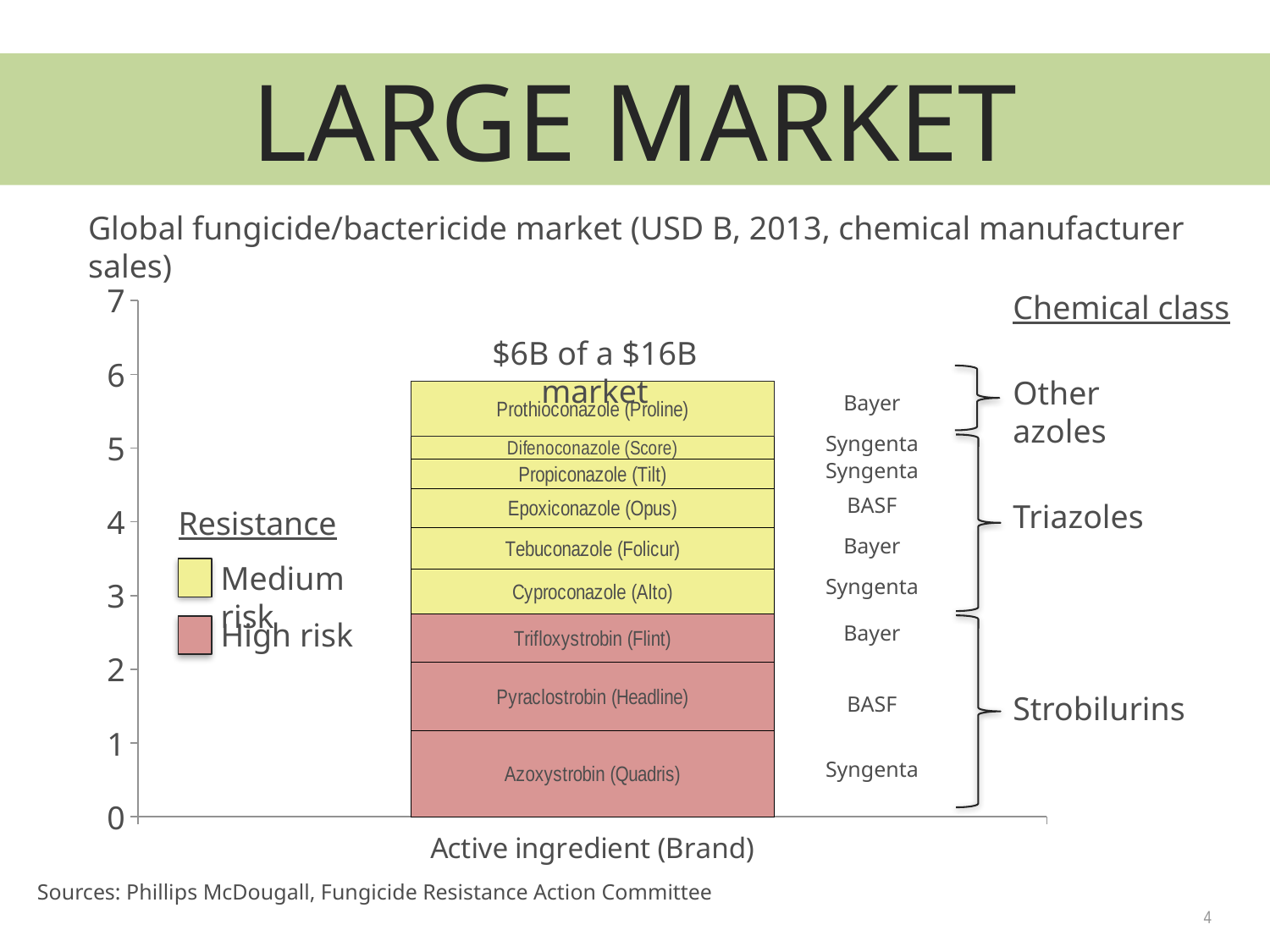
Which chemical class do the High risk segments belong to? Strobilurins What kind of chart is shown on the slide? stacked bar chart What is the x-axis title of the chart? Active ingredient (Brand) How many segments are shaded as High risk (red)? 3 Which active ingredient segment is the largest in the stacked bar? Azoxystrobin (Quadris) How many active ingredient segments make up the stacked bar? 9 How many risk categories does the Resistance legend list? 2 Which active ingredient segment is the smallest in the stacked bar? Difenoconazole (Score) Is the Pyraclostrobin (Headline) segment greater or less than 2 in height? less According to the annotation, what is the total value of the stacked bar? $6B Is the total height of the stacked bar greater or less than 5? greater Which segment is larger, Azoxystrobin (Quadris) or Difenoconazole (Score)? Azoxystrobin (Quadris)